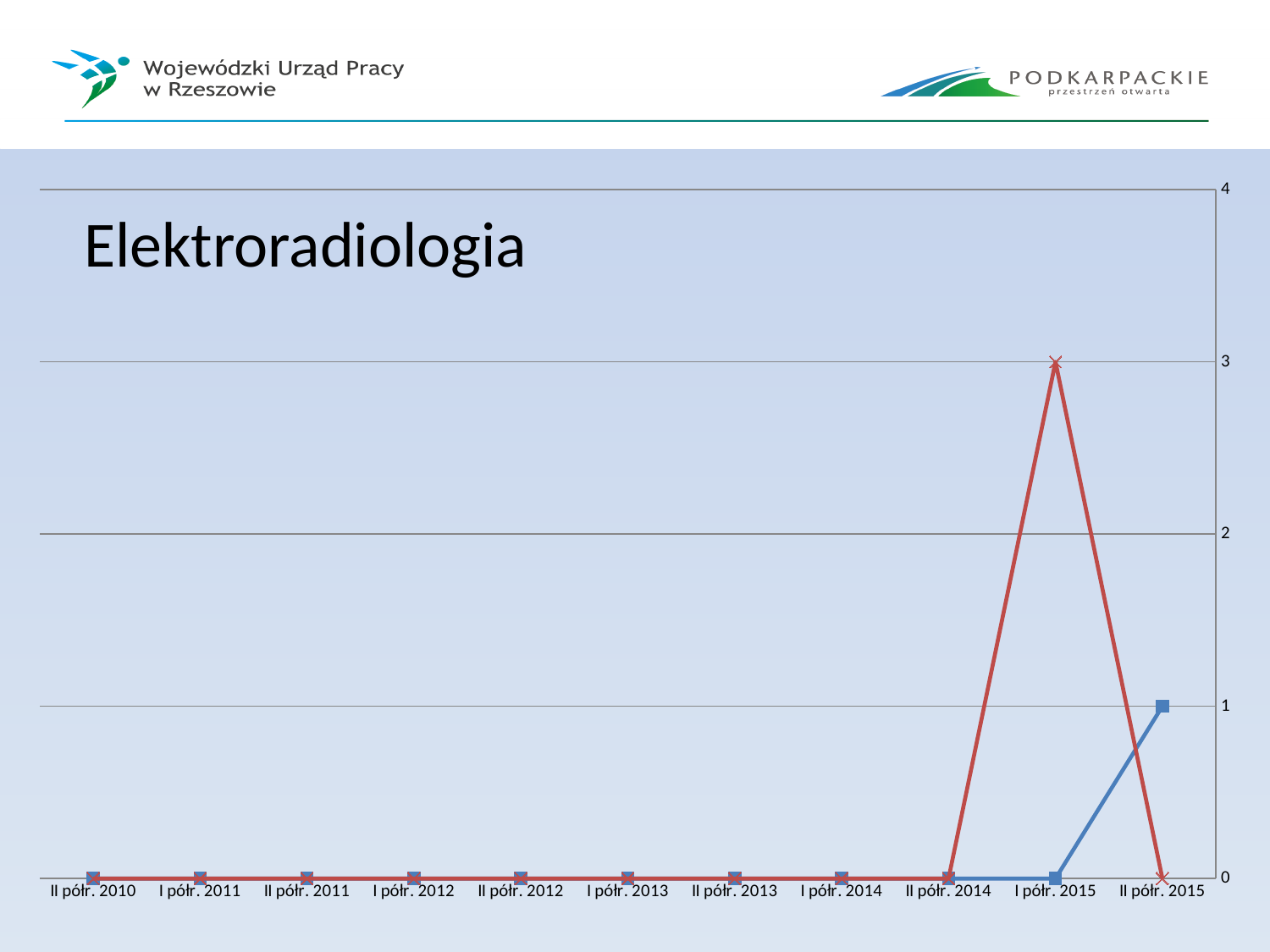
What is the difference between the red line's value at I półr. 2015 and the blue line's value at II półr. 2015? 2 Which line has the higher value at I półr. 2015, the red or the blue? red What is the title of the slide with the chart? Elektroradiologia What kind of chart is shown on the slide? line chart What is the value of the blue line at I półr. 2015? 0 How many periods are shown on the x axis of the chart? 11 In which period does the blue line reach its highest value? II półr. 2015 What is the value of the red line at II półr. 2015? 0 What is the value of the blue line at II półr. 2015? 1 What is the highest value shown on the vertical axis of the chart? 4 In which period does the red line reach its highest value? I półr. 2015 What is the value of the red line at I półr. 2015? 3